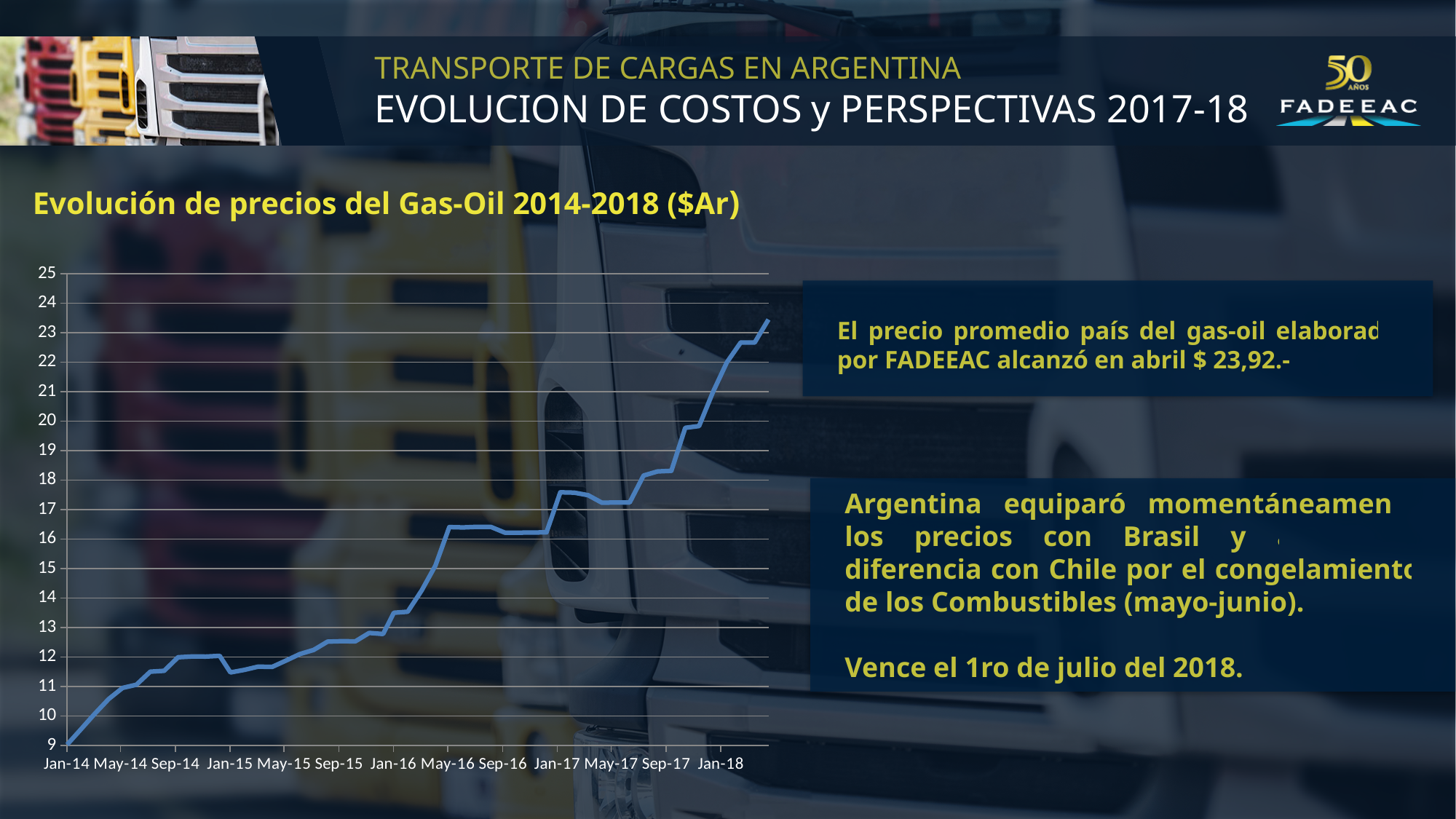
Is the value for Jan-14 greater or less than 10? less What kind of chart is shown on the slide? line chart Is the value for Jan-16 greater or less than 13? greater Is the value for May-16 greater or less than 16? greater What is the title of the chart? Evolución de precios del Gas-Oil 2014-2018 ($Ar) Which of the two dates has the higher value, Jan-15 or Jan-17? Jan-17 Do the gas-oil prices generally rise or fall from Jan-14 to Jan-18? rise How many date labels are shown on the x axis? 13